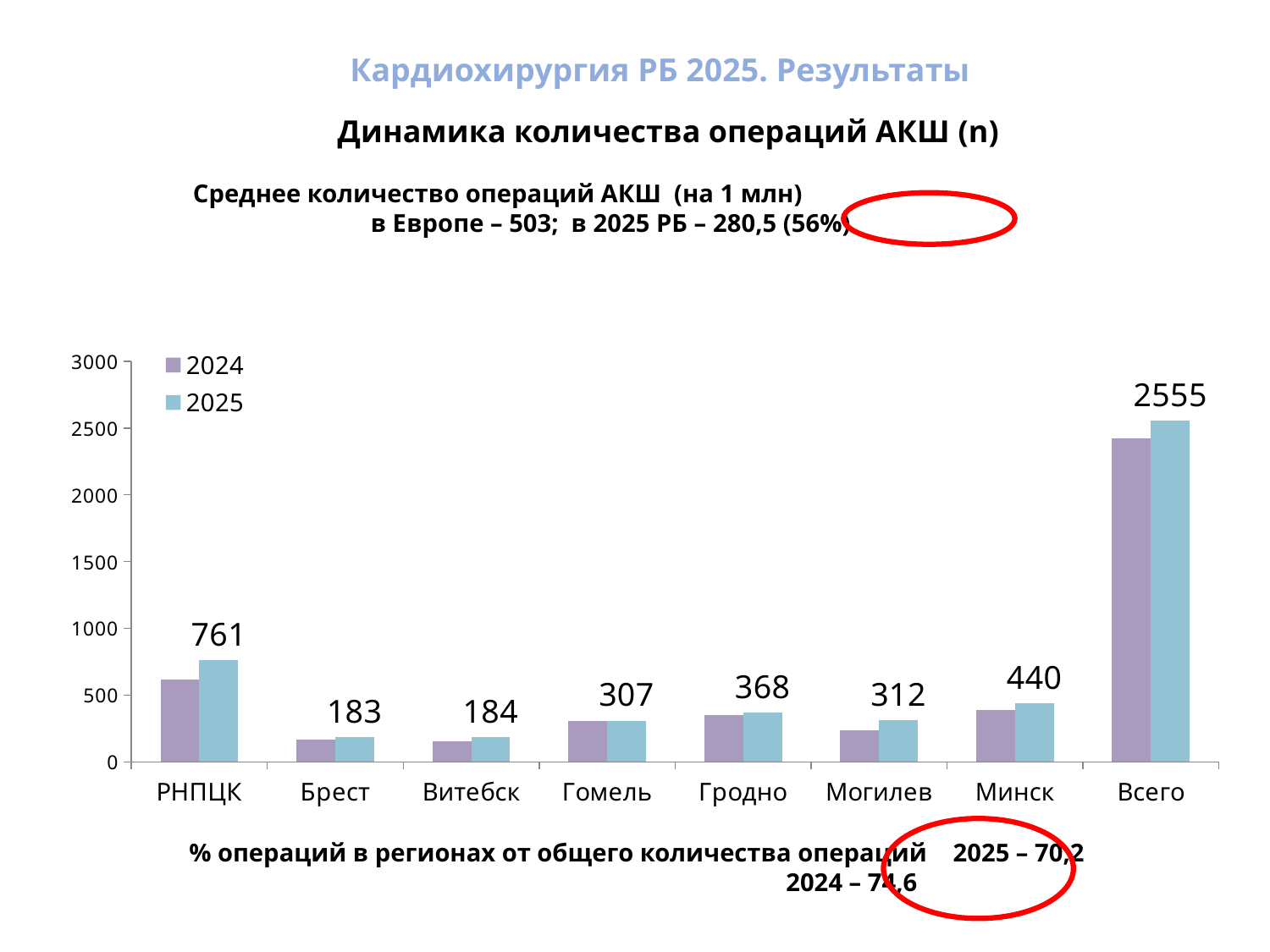
Is the 2024 value for РНПЦК greater or less than 500? greater What is the 2025 value for Всего? 2555 Which category has the highest 2025 value? Всего What is the 2025 value for Минск? 440 Which category has the lowest 2025 value? Брест What kind of chart is shown on the slide? bar chart Is the 2024 value for Всего greater or less than 2500? less How many series does the legend list? 2 What is the 2025 value for РНПЦК? 761 What is the difference between the 2025 values for Гродно and Гомель? 61 Which has the larger 2025 value, Минск or Гродно? Минск How many categories are shown on the x axis? 8